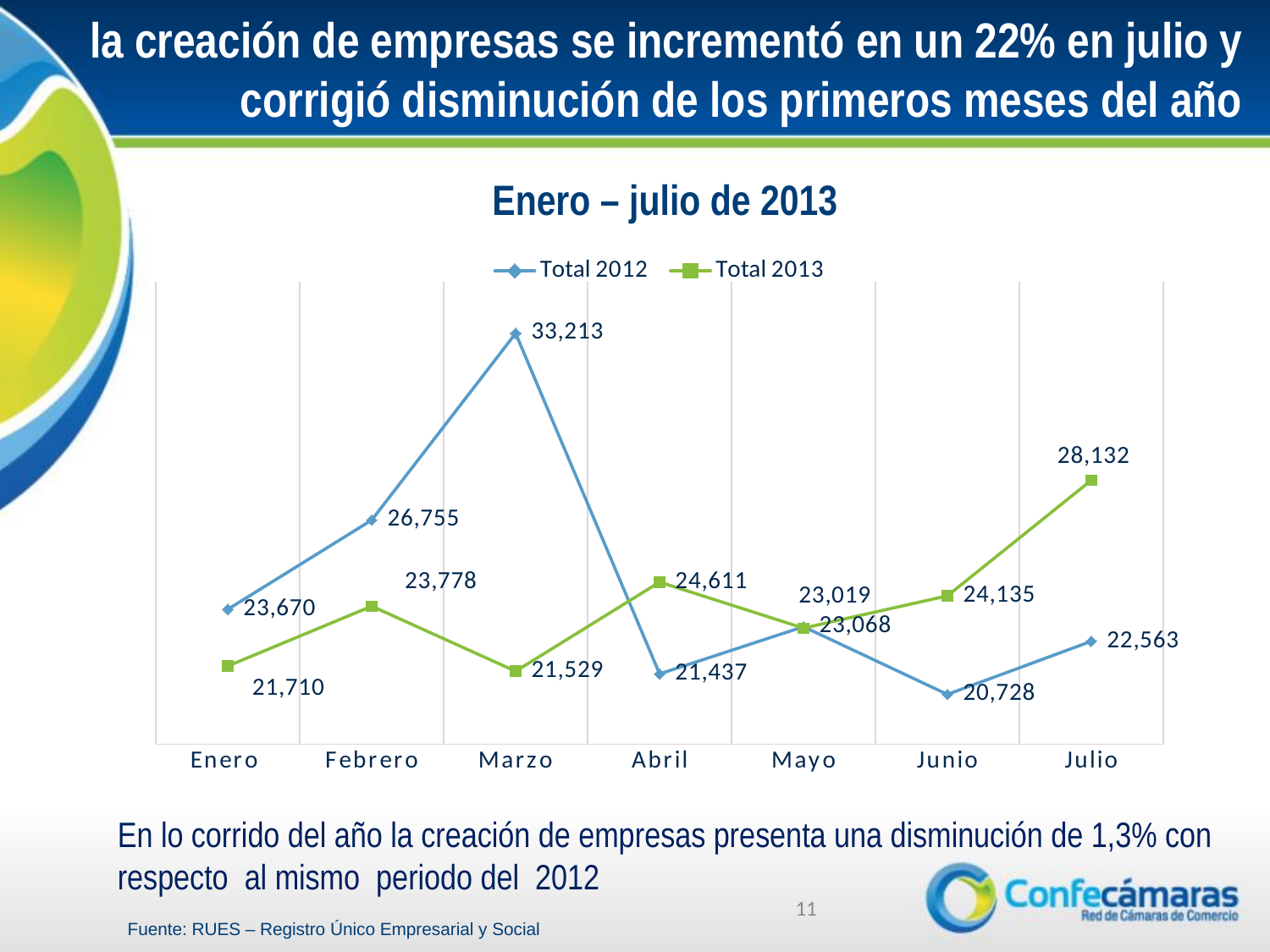
What are the two series named in the legend? Total 2012 and Total 2013 In which month is Total 2012 lowest? Junio What kind of chart is shown on the slide? line chart What is the value for Total 2013 in Julio? 28,132 In which month is Total 2012 highest? Marzo How many series does the legend list? 2 What is the value for Total 2012 in Marzo? 33,213 In Abril, which series has the larger value, Total 2012 or Total 2013? Total 2013 In which month is Total 2013 highest? Julio How many months are shown on the x axis? 7 What is the difference between Total 2013 and Total 2012 in Julio? 5,569 What is the value for Total 2013 in Abril? 24,611